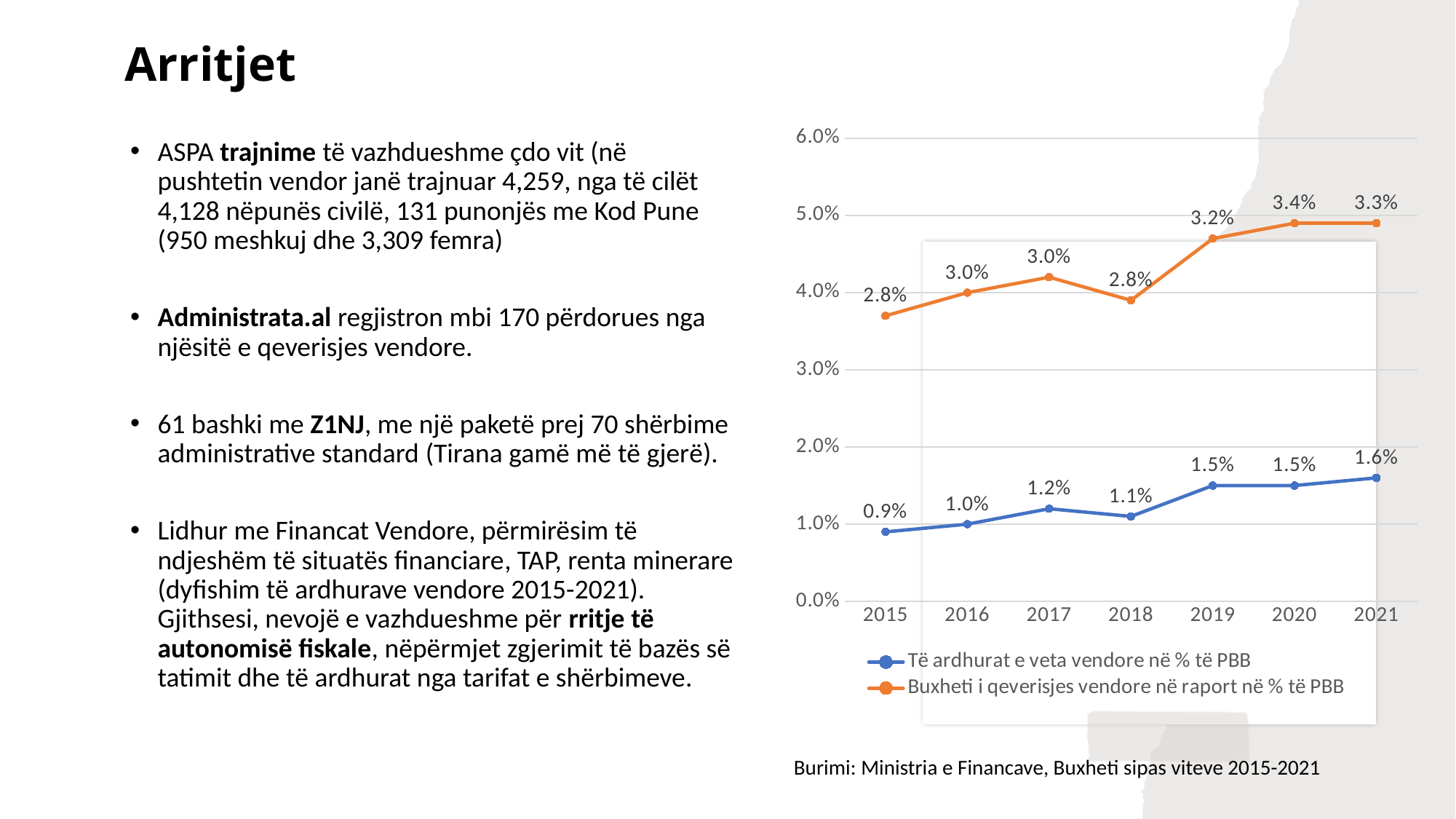
How many series does the chart legend list? 2 What kind of chart is shown on the slide? line chart In which year is 'Të ardhurat e veta vendore në % të PBB' lowest? 2015 Does 'Të ardhurat e veta vendore në % të PBB' generally rise or fall from 2015 to 2021? rise What is the value of 'Buxheti i qeverisjes vendore në raport në % të PBB' in 2020? 3.4% Which series has the larger value in 2019, 'Të ardhurat e veta vendore në % të PBB' or 'Buxheti i qeverisjes vendore në raport në % të PBB'? Buxheti i qeverisjes vendore në raport në % të PBB What is the value of 'Të ardhurat e veta vendore në % të PBB' in 2021? 1.6% What is the value of 'Të ardhurat e veta vendore në % të PBB' in 2015? 0.9% What is the difference between the 2021 and 2015 values of 'Të ardhurat e veta vendore në % të PBB'? 0.7% What colour is the line for 'Buxheti i qeverisjes vendore në raport në % të PBB'? orange In which year is 'Buxheti i qeverisjes vendore në raport në % të PBB' highest according to the data labels? 2020 How many years are shown on the x axis of the chart? 7